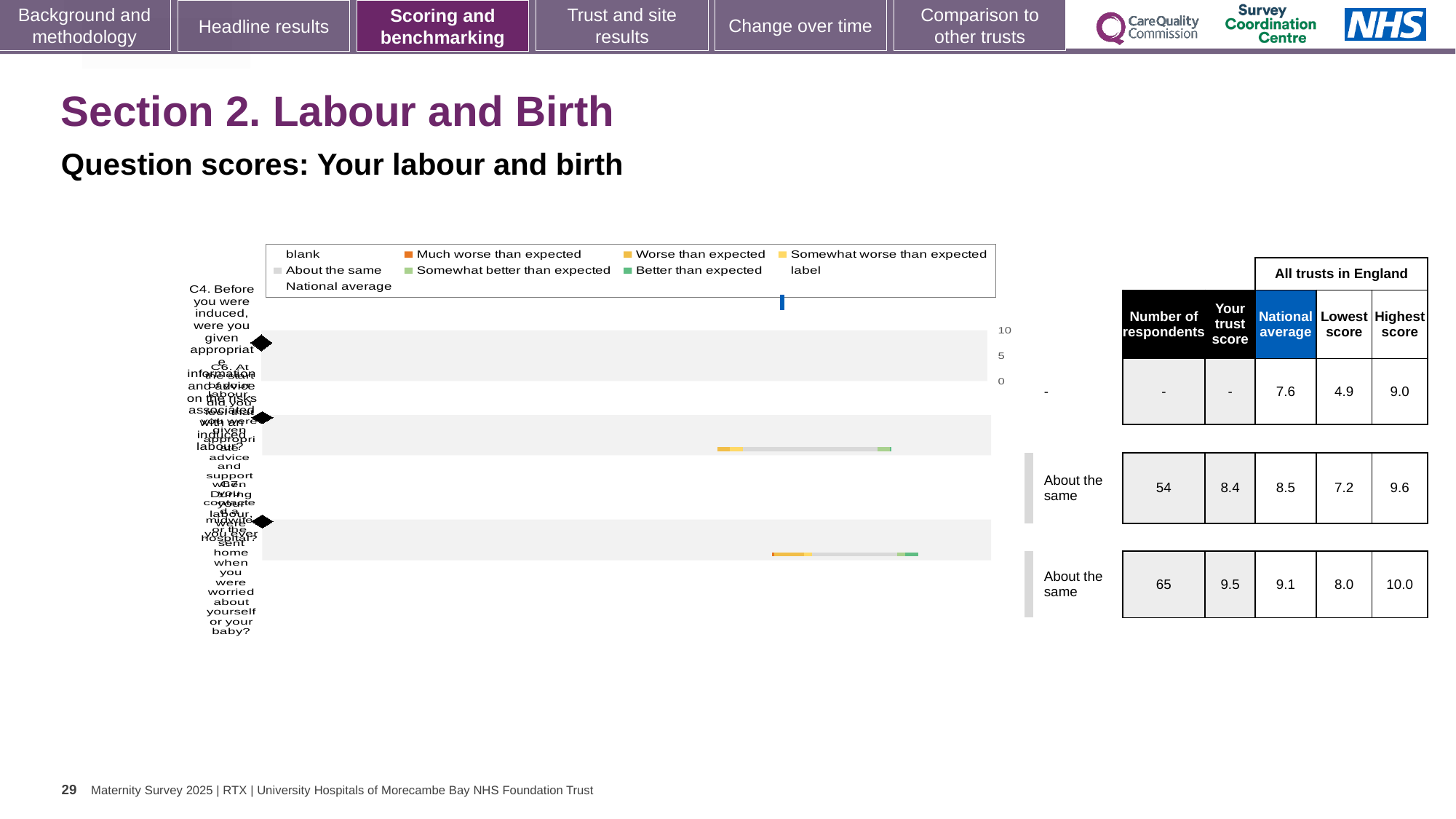
In the table beside the chart, what is the highest score among all trusts in England for the first question row? 9.0 In the table beside the chart, what is the number of respondents for the second question row? 54 For the third question row, what is the difference between the trust score (9.5) and the national average (9.1)? 0.4 What is the highest tick value shown on the chart's score axis? 10 In the table beside the chart, what is the trust score for the third question row? 9.5 In the table beside the chart, what is the lowest score among all trusts in England for the second question row? 7.2 For the third question row, which is larger: the trust score or the national average? trust score What colour is the legend entry 'Much worse than expected'? orange How many question rows (categories) are plotted in the chart? 3 What kind of chart is shown on the slide? bar chart How many entries does the chart legend list? 9 In the table beside the chart, what is the national average for the first question row? 7.6